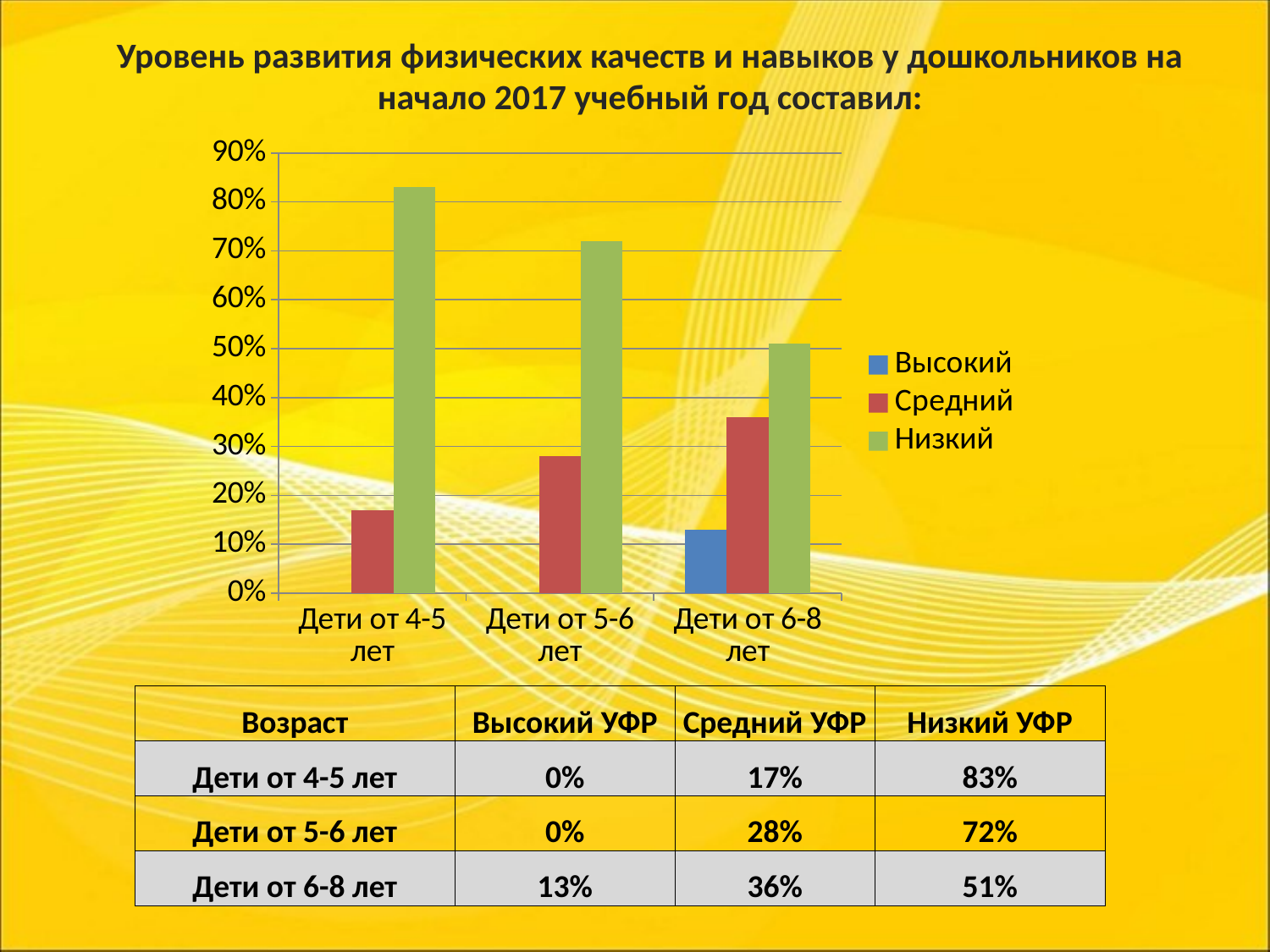
Which colour represents the Низкий series in the chart? green Does the Низкий value for Дети от 5-6 лет rise or fall compared with Дети от 4-5 лет, and then for Дети от 6-8 лет? falls Which age category has the highest Низкий value? Дети от 4-5 лет What is the difference between the Низкий values for Дети от 4-5 лет and Дети от 6-8 лет? 32% What kind of chart is shown on the slide? bar chart How many age categories are shown on the x axis of the chart? 3 What is the value of Высокий for Дети от 6-8 лет? 13% Which age category has the lowest Средний value? Дети от 4-5 лет Which is larger: the Средний value for Дети от 6-8 лет or the Средний value for Дети от 5-6 лет? Дети от 6-8 лет What is the value of Средний for Дети от 5-6 лет? 28% How many series does the chart legend list? 3 What is the value of Низкий for Дети от 4-5 лет? 83%